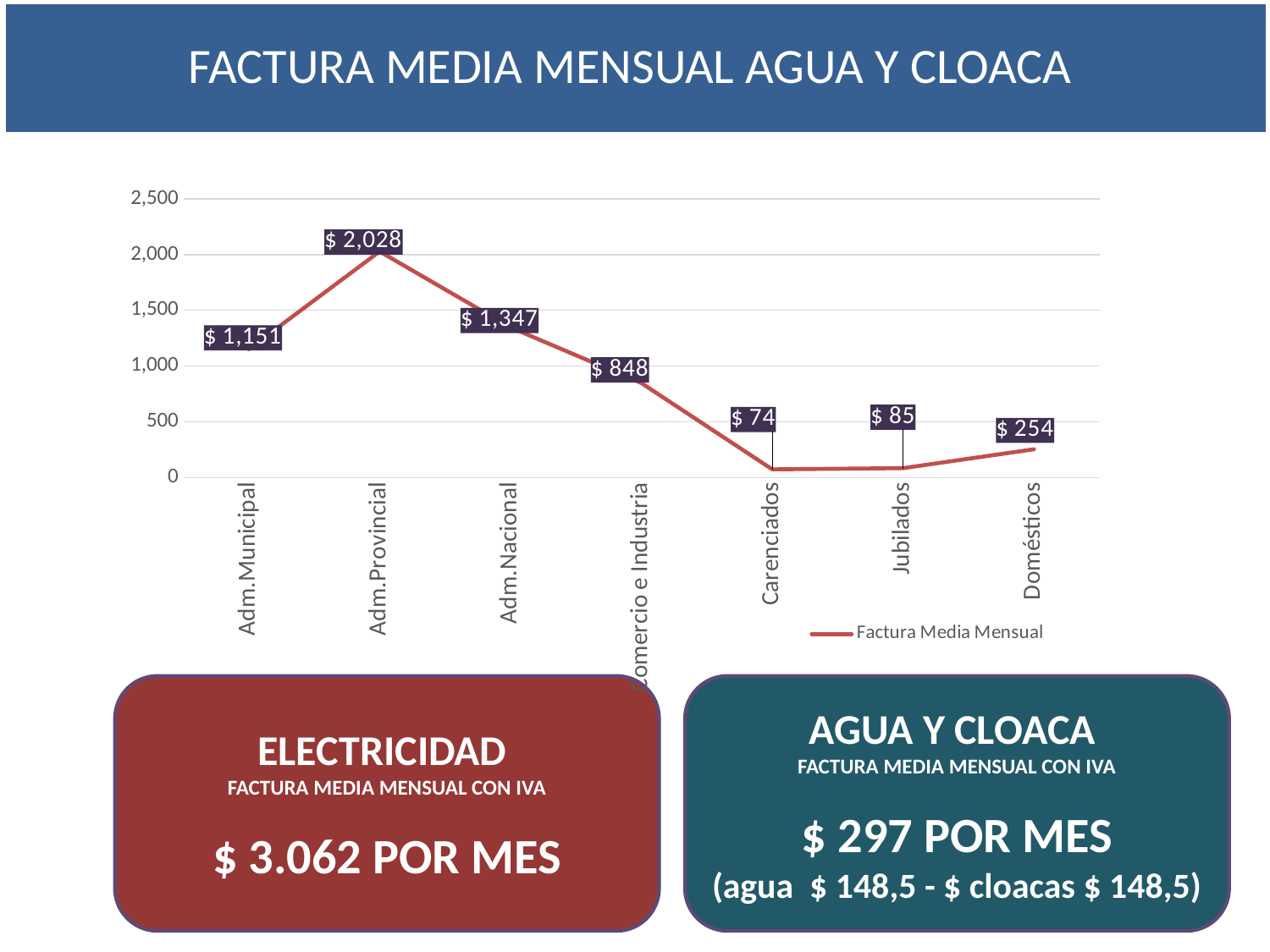
Which category has the highest Factura Media Mensual? Adm.Provincial What is the name of the series shown in the legend? Factura Media Mensual What is the Factura Media Mensual value for Adm.Provincial? $ 2,028 What type of chart is shown on the slide? Line chart What is the Factura Media Mensual value for Comercio e Industria? $ 848 Which is larger, the value for Adm.Municipal or the value for Adm.Nacional? Adm.Nacional How many series does the legend list? 1 What is the difference between the values for Adm.Provincial and Adm.Nacional? $ 681 Which category has the lowest Factura Media Mensual? Carenciados What is the difference between the values for Jubilados and Carenciados? $ 11 What is the Factura Media Mensual value for Domésticos? $ 254 How many categories are plotted on the x axis? 7